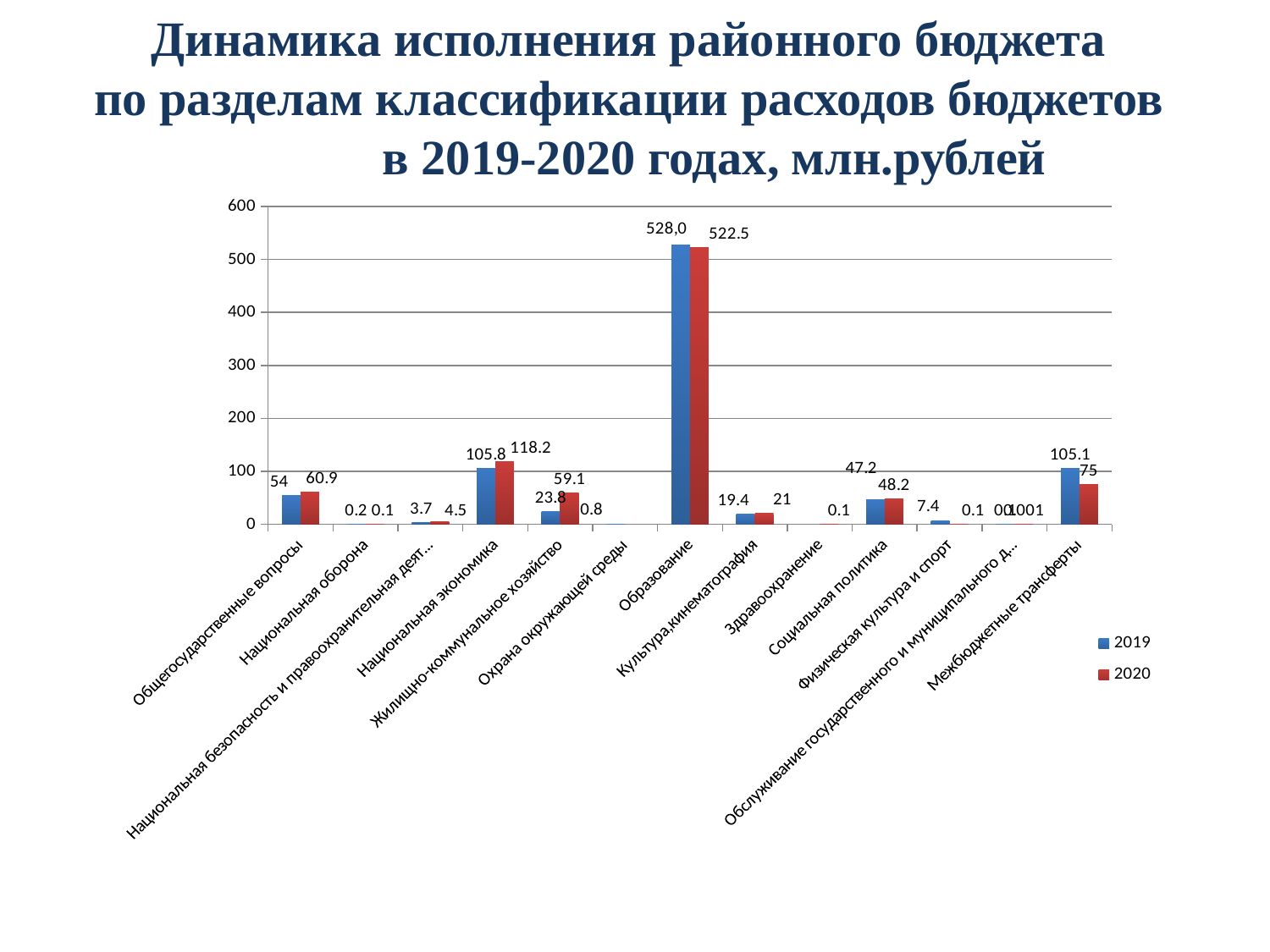
What is the 2019 value for Социальная политика? 47.2 How many series does the legend list? 2 How many categories are shown on the x axis? 13 For Жилищно-коммунальное хозяйство, which year has the larger value, 2019 or 2020? 2020 By how much did the value for Национальная экономика increase from 2019 to 2020? 12.4 What is the 2020 value for Образование? 522.5 What is the difference between the 2019 and 2020 values for Межбюджетные трансферты? 30.1 What is the 2020 value for Национальная экономика? 118.2 What is the 2019 value for Образование? 528,0 What kind of chart is shown on the slide? bar chart What are the two entries in the legend? 2019 and 2020 Which category has the highest 2019 value? Образование